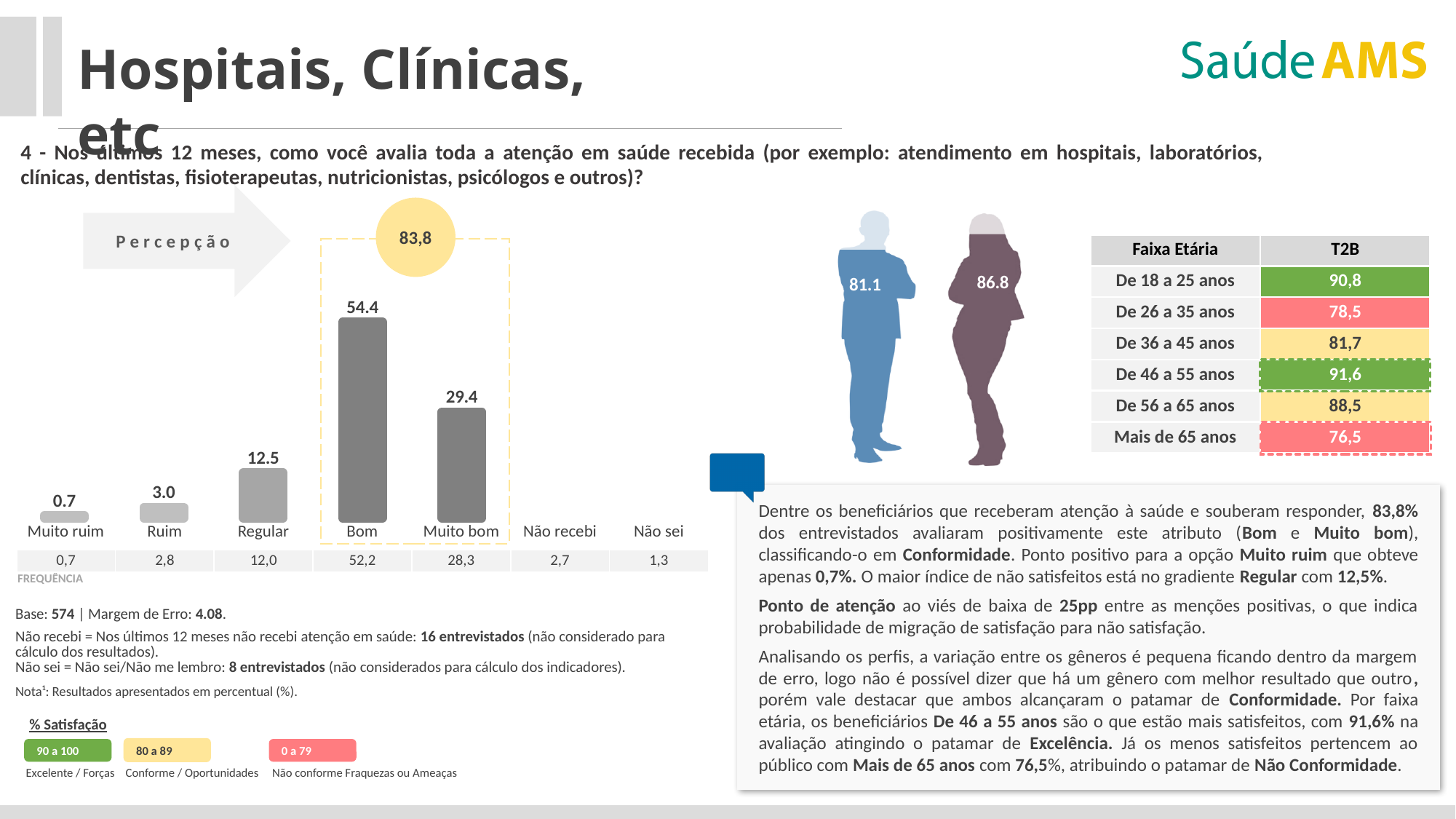
What is the value for Bom in the bar chart? 54.4 What kind of chart is shown on the left of the slide? Bar chart Which category with a plotted bar has the lowest value in the bar chart? Muito ruim Which is larger in the bar chart, Ruim or Regular? Regular What is the value for Regular in the bar chart? 12.5 What is the value for Ruim in the bar chart? 3.0 How many bars are plotted in the bar chart? 5 What is the value for Muito ruim in the bar chart? 0.7 What is the combined value of Bom and Muito bom shown in the circle above the bar chart? 83.8 What is the value for Muito bom in the bar chart? 29.4 What is the difference between the values for Bom and Muito bom in the bar chart? 25.0 Which category has the highest value in the bar chart? Bom